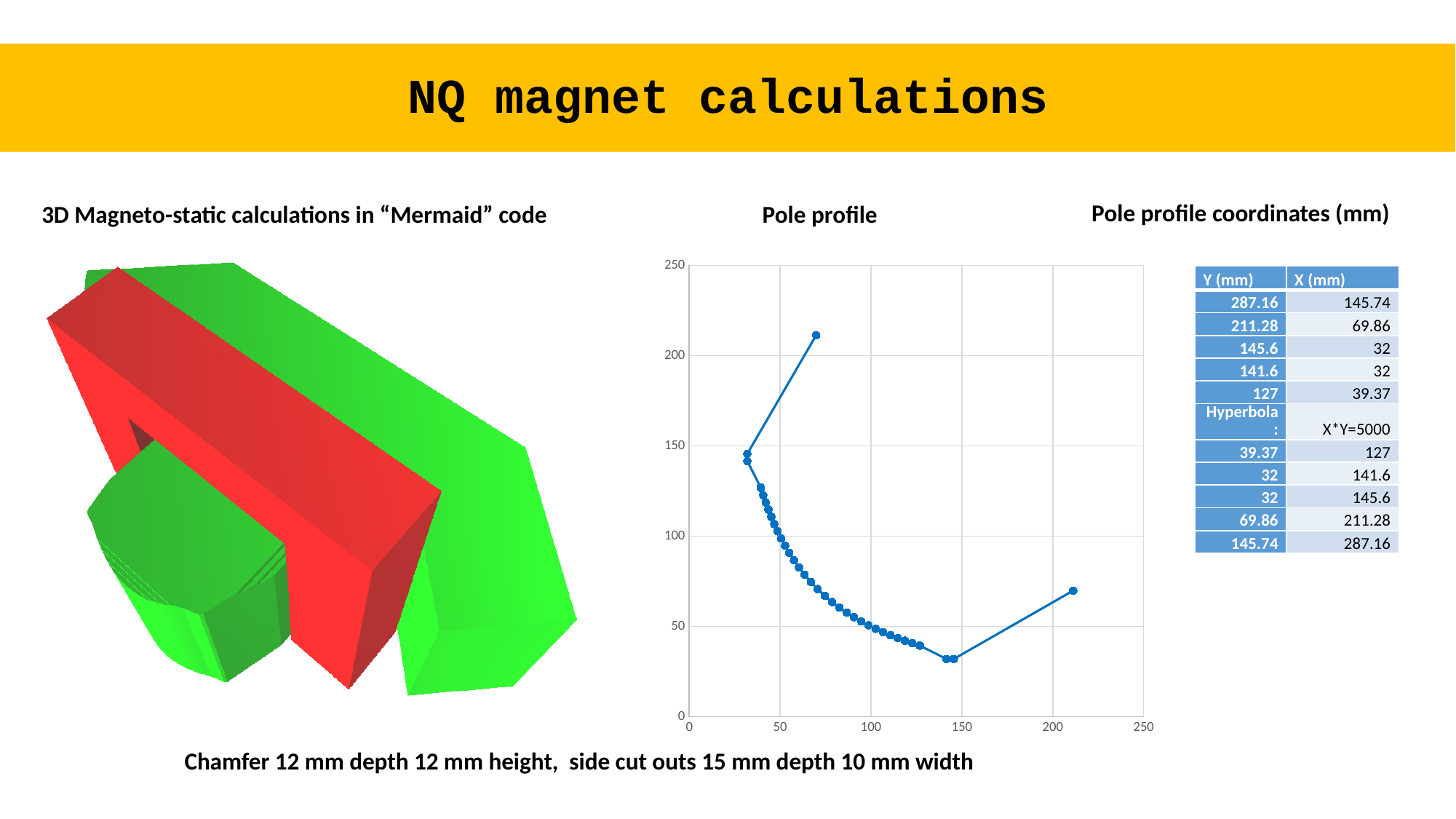
According to the "Pole profile coordinates (mm)" table, what is the largest Y (mm) value listed? 287.16 In the "Pole profile" chart, is the x value of the leftmost point greater or less than 50? less In the "Pole profile" chart, is the y value of the lowest point greater or less than 50? less In the "Pole profile" chart, is the y value of the topmost point greater or less than 200? greater In the "Pole profile" chart, do the y values of the densely plotted curved section rise or fall as x increases from about 40 to about 125? fall What is the title of the chart in the middle of the slide? Pole profile According to the "Pole profile coordinates (mm)" table, what is X (mm) when Y (mm) is 211.28? 69.86 According to the "Pole profile coordinates (mm)" table, what is X (mm) when Y (mm) is 127? 39.37 In the "Pole profile" chart, which point has the larger y value: the topmost point near x=70 or the rightmost point near x=210? the topmost point near x=70 What kind of chart is the "Pole profile" chart? scatter chart In the "Pole profile" chart, what is the highest value shown on the x axis? 250